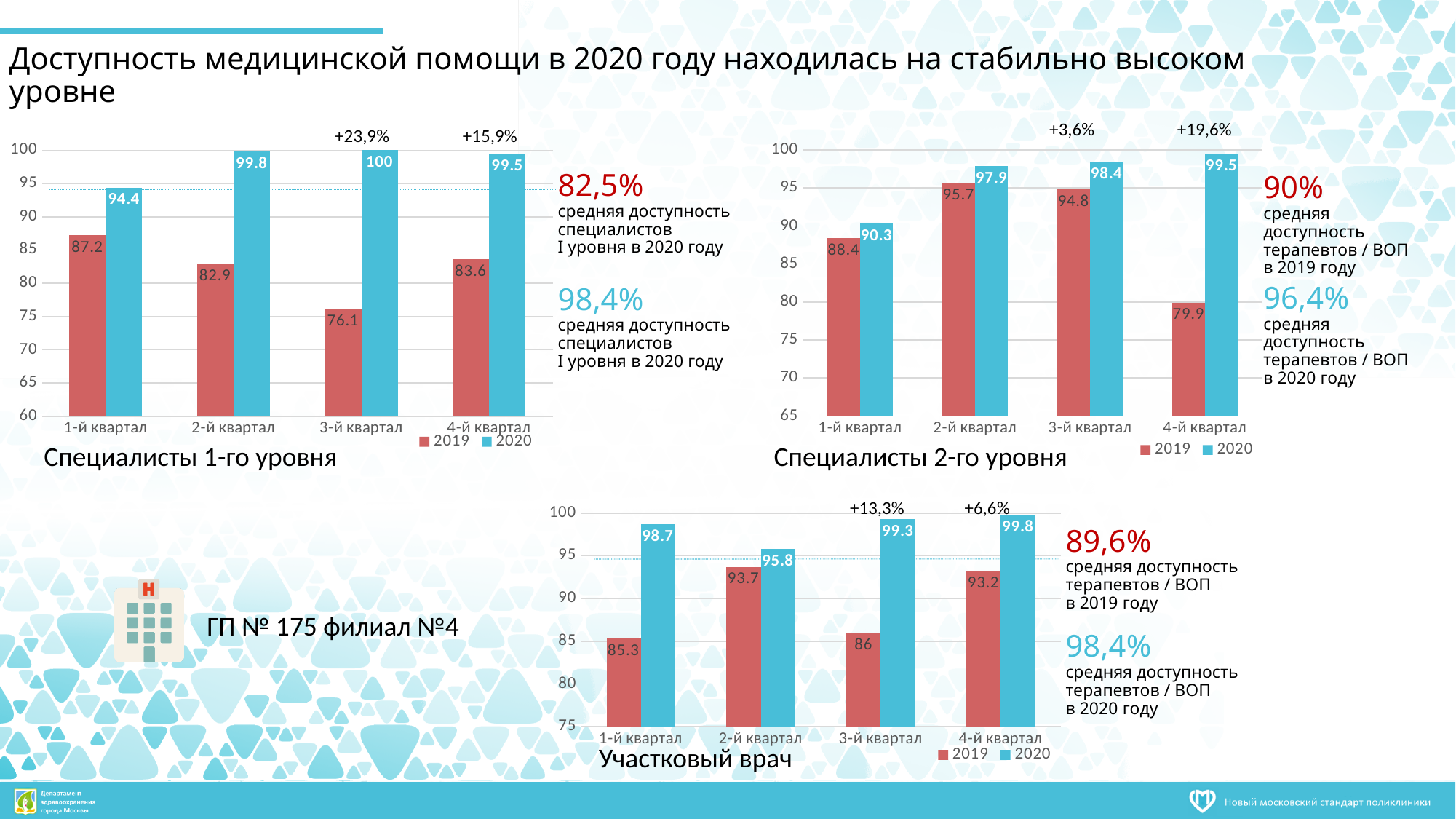
In the chart 'Специалисты 1-го уровня', which quarter has the lowest 2019 value? 3-й квартал In the chart 'Специалисты 2-го уровня', what is the 2019 value for 4-й квартал? 79.9 In the chart 'Участковый врач', what is the difference between the 2020 and 2019 values in 3-й квартал? 13.3 In the chart 'Специалисты 1-го уровня', what is the difference between the 2020 and 2019 values in 1-й квартал? 7.2 In the chart 'Участковый врач', which quarter has the lowest 2019 value? 1-й квартал How many series does the legend list in the chart 'Участковый врач'? 2 In the chart 'Участковый врач', what is the 2020 value for 1-й квартал? 98.7 How many quarters are shown on the x axis of the chart 'Специалисты 1-го уровня'? 4 In the chart 'Специалисты 2-го уровня', which quarter has the highest 2020 value? 4-й квартал In the chart 'Специалисты 2-го уровня', which is larger: the 2019 value in 2-й квартал or the 2019 value in 3-й квартал? 2-й квартал What type of chart is 'Специалисты 2-го уровня'? Bar chart In the chart 'Специалисты 1-го уровня', what is the value for 2020 in 3-й квартал? 100